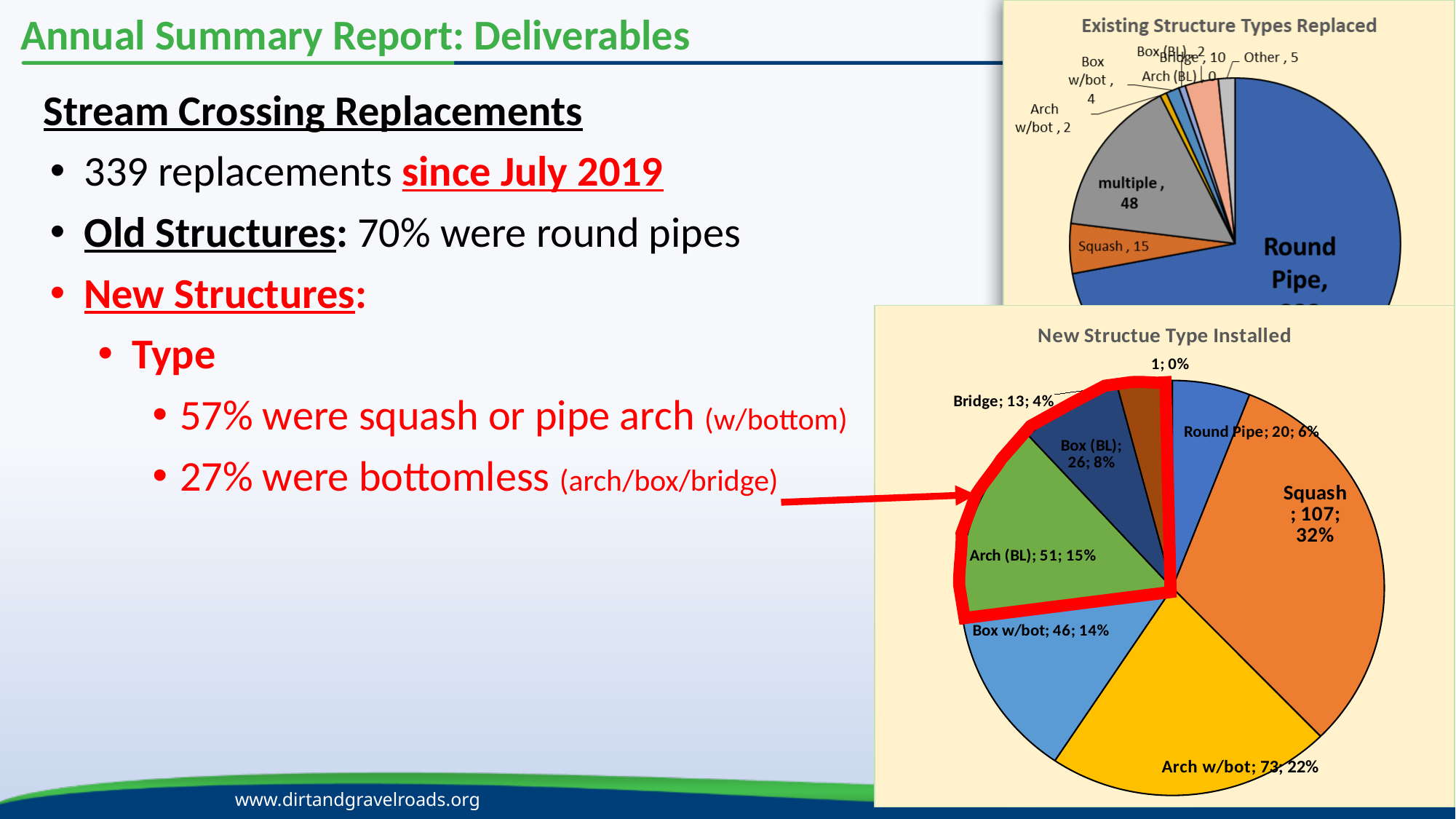
In the 'New Structue Type Installed' chart, how many Squash structures were installed? 107 In the 'New Structue Type Installed' chart, what is the value for Box (BL)? 26 In the 'New Structue Type Installed' chart, what percentage share does Box (BL) have? 8% In the 'Existing Structure Types Replaced' chart, what is the value for multiple? 48 In the 'New Structue Type Installed' chart, which labelled category has the largest slice? Squash What kind of chart is 'New Structue Type Installed'? Pie chart In the 'New Structue Type Installed' chart, which is larger, Round Pipe or Bridge? Round Pipe In the 'Existing Structure Types Replaced' chart, which is larger, Bridge or Other? Bridge In the 'Existing Structure Types Replaced' chart, what is the value for Squash? 15 In the 'New Structue Type Installed' chart, what is the difference between the Arch (BL) and Box w/bot values? 5 In the 'New Structue Type Installed' chart, what share of the pie is Arch w/bot? 22% In the 'Existing Structure Types Replaced' chart, what is the difference between the multiple and Squash values? 33